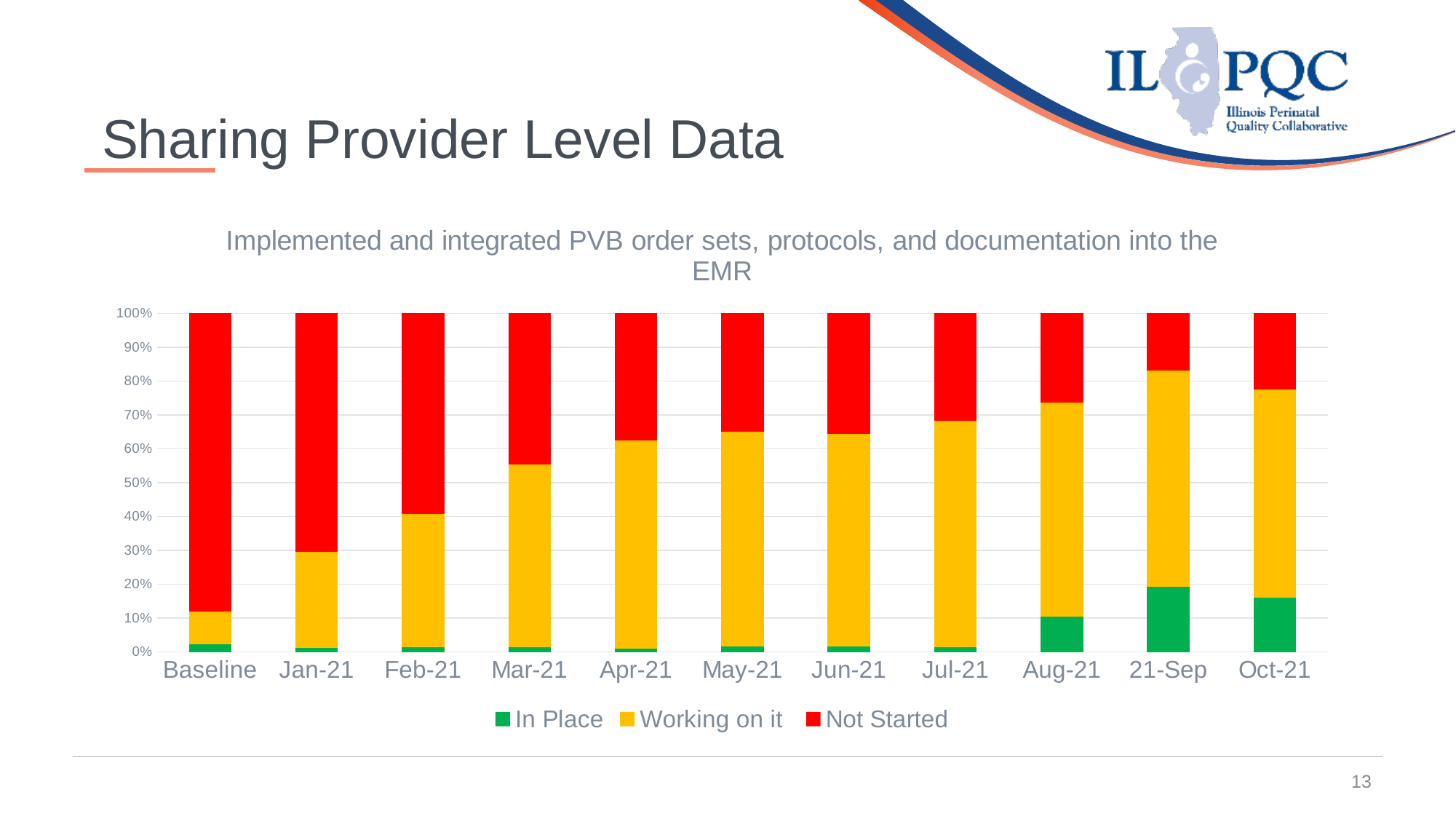
What is the title of the chart? Implemented and integrated PVB order sets, protocols, and documentation into the EMR Is the In Place value for 21-Sep greater or less than 10%? greater Does the Not Started share rise or fall from Baseline to Oct-21? Fall Is the Not Started value for Oct-21 greater or less than 30%? less How many categories are shown along the x axis? 11 How many series does the legend list? 3 What kind of chart is shown on the slide? Stacked bar chart Which category has the highest value for the Not Started series? Baseline Which category has the highest value for the In Place series? 21-Sep Is the Working on it value for Feb-21 greater or less than 30%? greater Which is larger, the Not Started value for Baseline or for Oct-21? Baseline